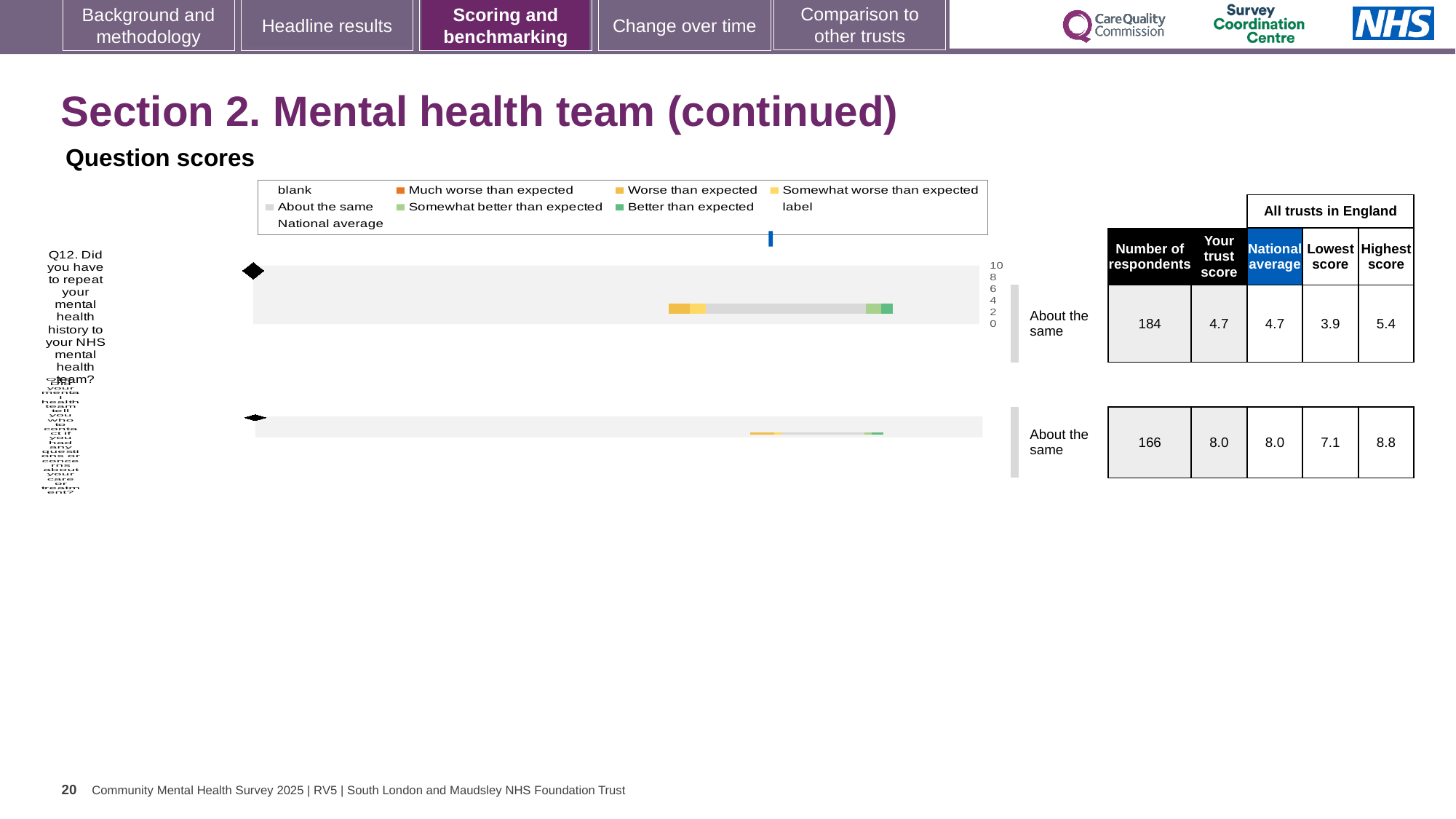
What is the number of respondents for Q12 (repeating mental health history to the NHS mental health team)? 184 What kind of chart is used to show the question scores on this slide? Bar chart What is the difference between the highest and lowest trust scores in England for Q12? 1.5 What is the national average score for Q12? 4.7 Which question has more respondents, Q12 or the second (lower) question? Q12 What colour does the legend use for 'Much worse than expected'? Orange What is the trust's score for the second (lower) question on the slide? 8.0 What is the trust's score for Q12? 4.7 How many questions (bars) are plotted in the question scores chart? 2 What benchmark category is shown for Q12 next to the chart? About the same What is the highest score among all trusts in England for Q12? 5.4 What is the lowest score among all trusts in England for the second (lower) question on the slide? 7.1